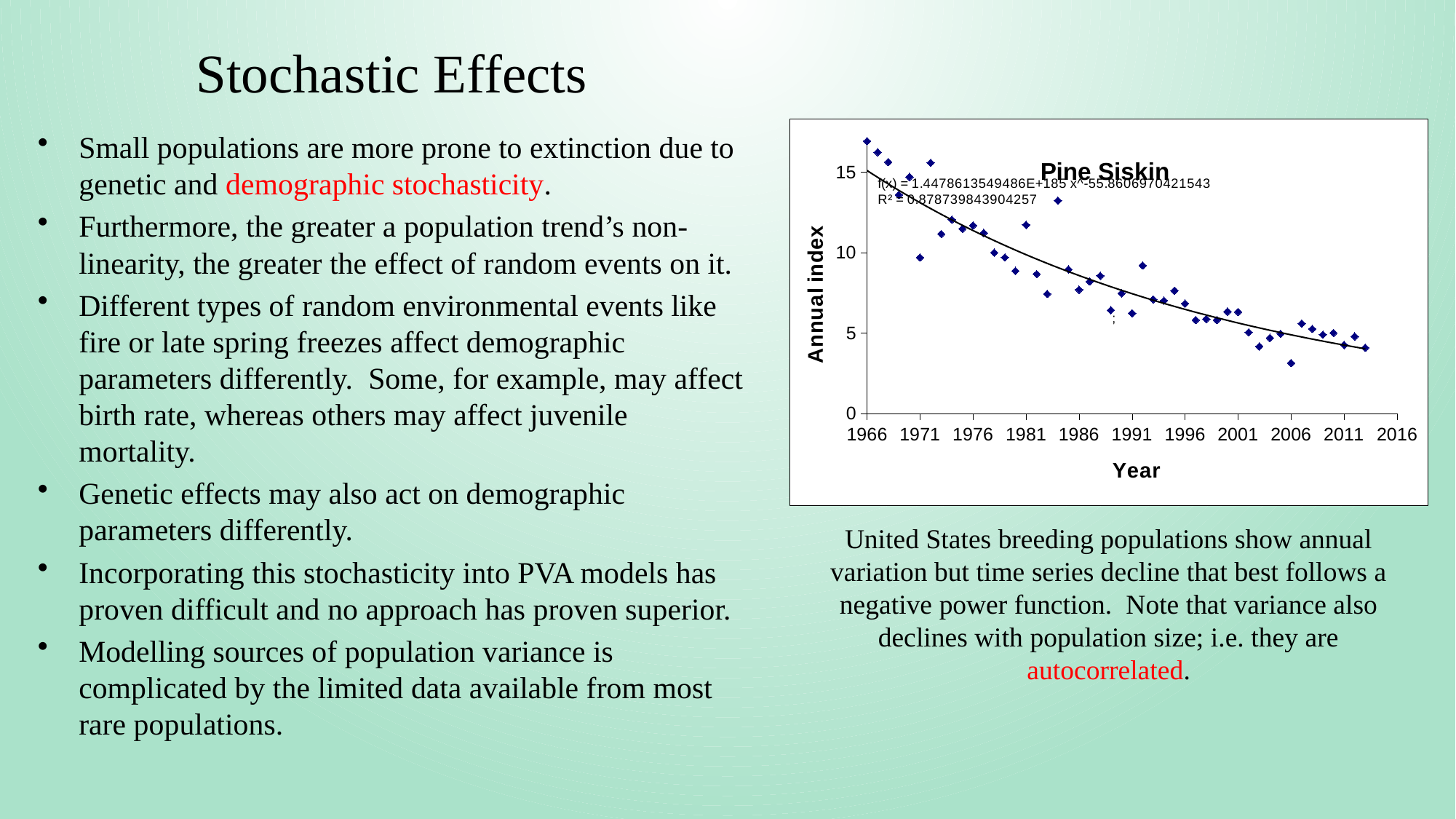
Do the annual index values generally rise or fall as the year increases? Fall What R² value is printed on the chart for the fitted trendline? 0.878739843904257 What is the title of the chart? Pine Siskin Is the annual index for 2013 greater or less than 5? less Which year has the highest annual index in the chart? 1966 What kind of chart is shown on the slide? Scatter plot Which has the larger annual index, 1966 or 2013? 1966 Is the annual index for 2006 greater or less than 5? less What is the highest tick value shown on the y axis of the chart? 15 Is the annual index for 1981 greater or less than 10? greater What is the label of the y axis of the chart? Annual index